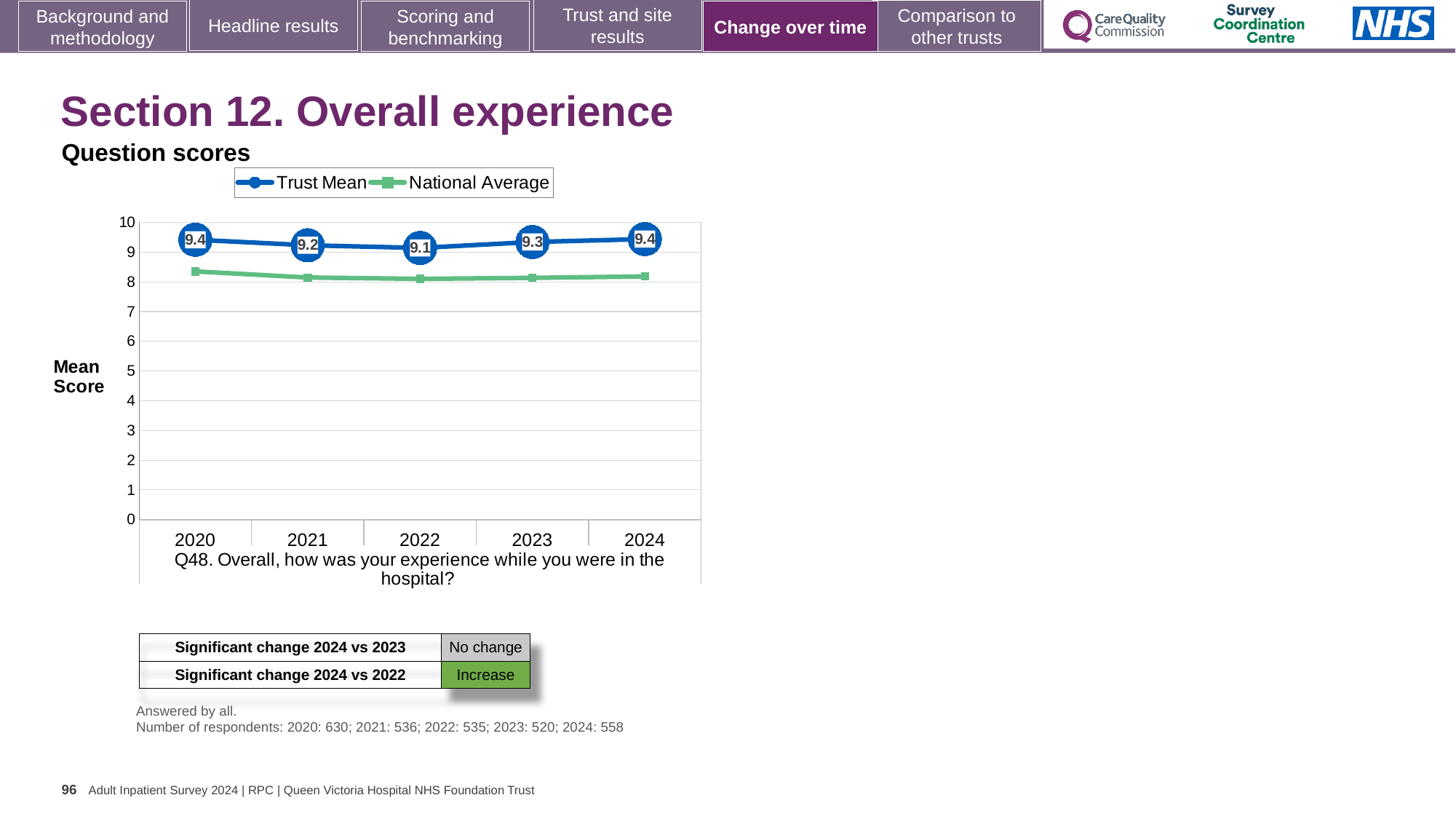
What kind of chart is shown on the slide? Line chart What is the Trust Mean score for 2024? 9.4 In which year is the Trust Mean score lowest? 2022 Is the National Average value for 2020 greater or less than 8? greater Is the National Average value for 2022 greater or less than 9? less What is the Trust Mean score for 2022? 9.1 How many series does the legend list? 2 Which year has the higher Trust Mean score, 2021 or 2023? 2023 What is the difference between the Trust Mean scores for 2024 and 2022? 0.3 How many years are plotted on the x axis? 5 What is the Trust Mean score for 2021? 9.2 Does the Trust Mean score rise or fall from 2022 to 2024? Rise